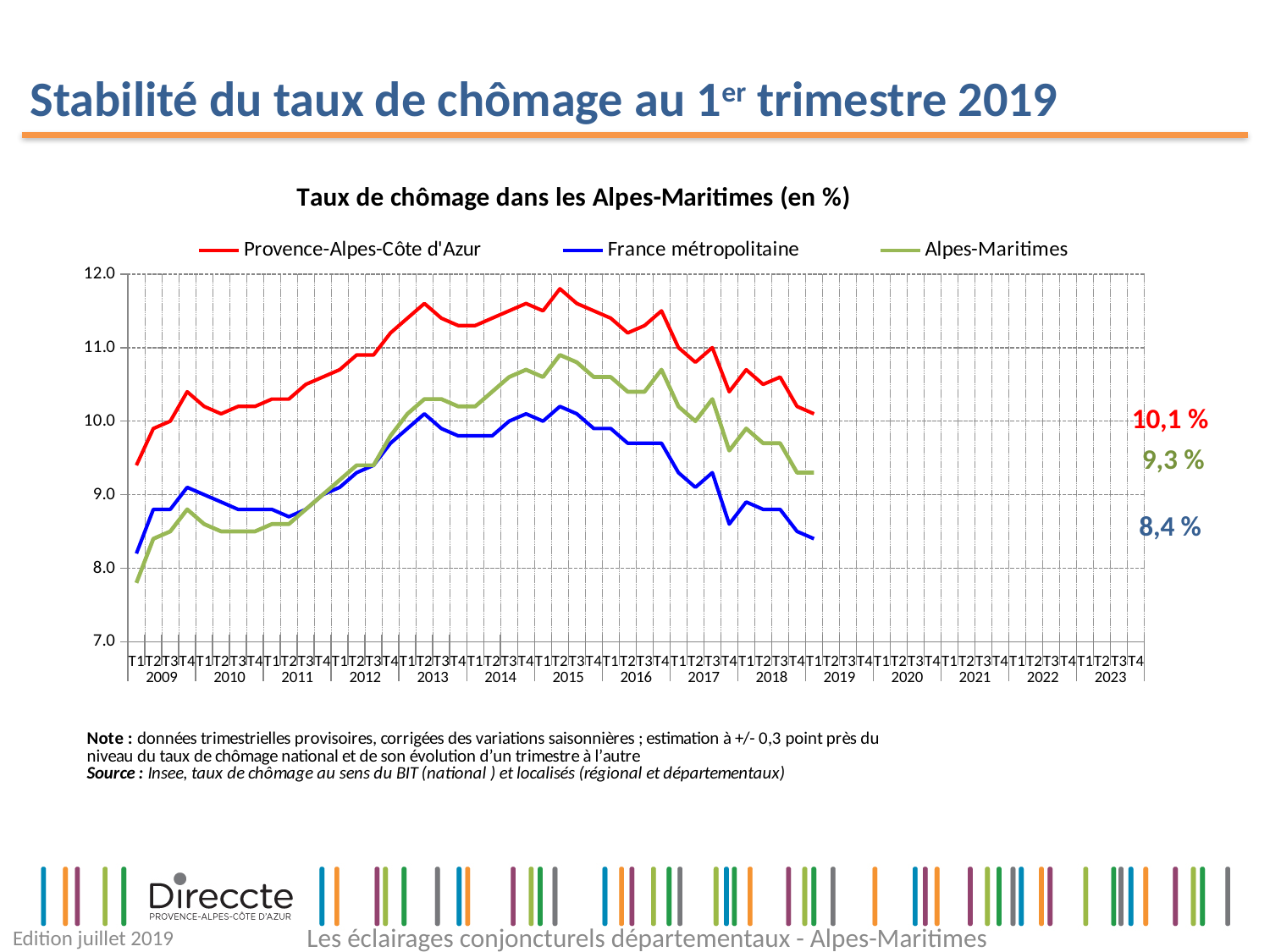
What is the latest value shown for Alpes-Maritimes? 9,3 % At T1 2019, which is larger: the rate for Provence-Alpes-Côte d'Azur or for France métropolitaine? Provence-Alpes-Côte d'Azur What is the difference between the latest values for Provence-Alpes-Côte d'Azur and Alpes-Maritimes? 0,8 points What kind of chart is shown on the slide? Line chart Is the peak value for Provence-Alpes-Côte d'Azur in 2015 greater or less than 11.0? greater Which series has the lowest value at T1 2019? France métropolitaine What is the difference between the latest values for Alpes-Maritimes and France métropolitaine? 0,9 points Which series has the highest value at T1 2019? Provence-Alpes-Côte d'Azur Is the value for France métropolitaine at T1 2009 greater or less than 9.0? less What is the unemployment rate shown for Provence-Alpes-Côte d'Azur at the end of the series (T1 2019)? 10,1 % What is the latest value shown for France métropolitaine? 8,4 % How many series does the legend list? 3